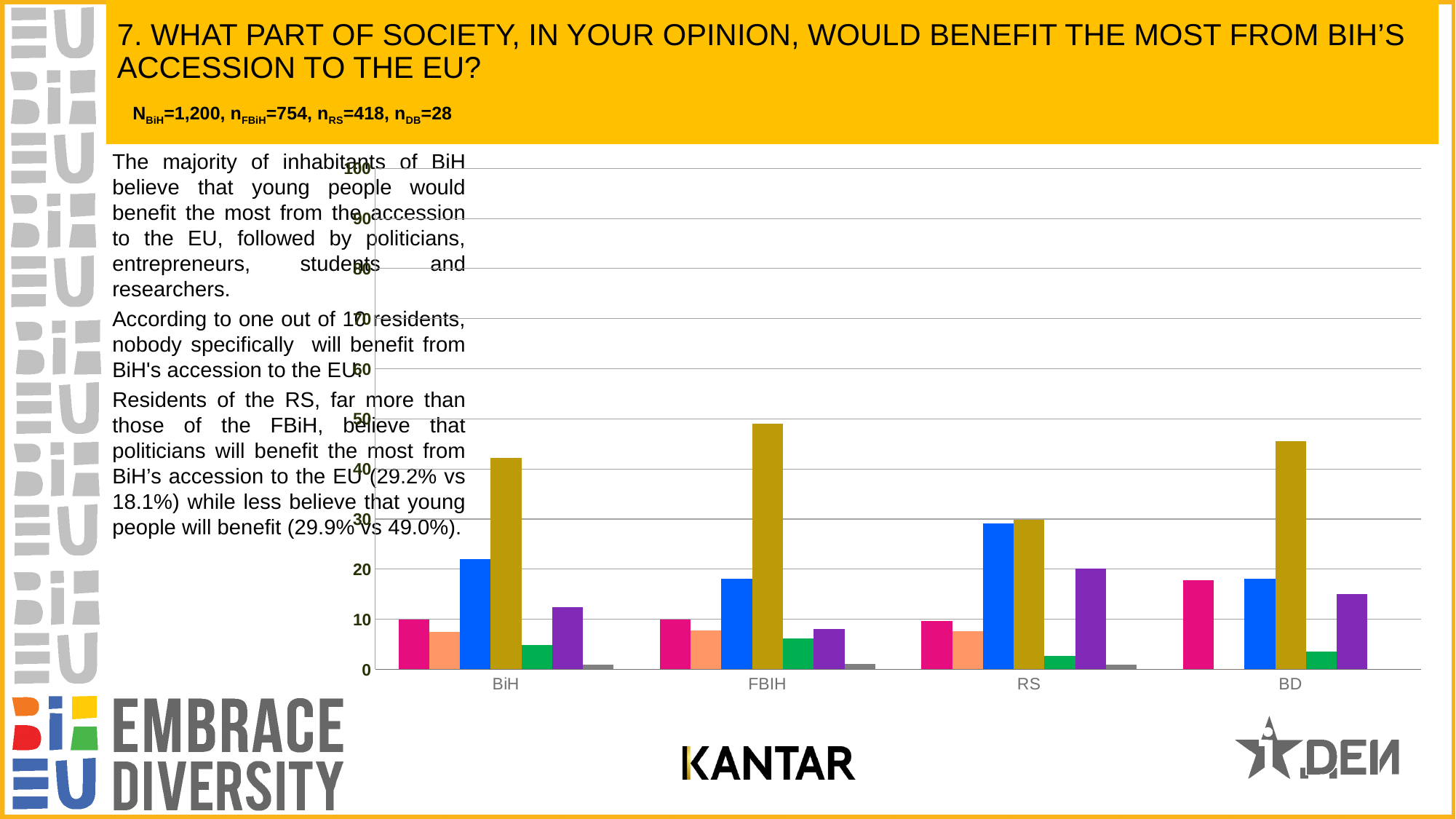
Is the tallest bar in the FBIH group greater or less than 40? greater Is the tallest bar in the BiH group greater or less than 30? greater What is the highest value shown on the y axis of the chart? 100 How many categories are shown on the x axis of the chart? 4 What are the category labels on the x axis of the chart? BiH, FBIH, RS, BD Which group has a taller tallest bar, FBIH or RS? FBIH Is the tallest bar in the BD group greater or less than 50? less Which group has a taller tallest bar, BiH or RS? BiH What kind of chart is shown on the slide? bar chart